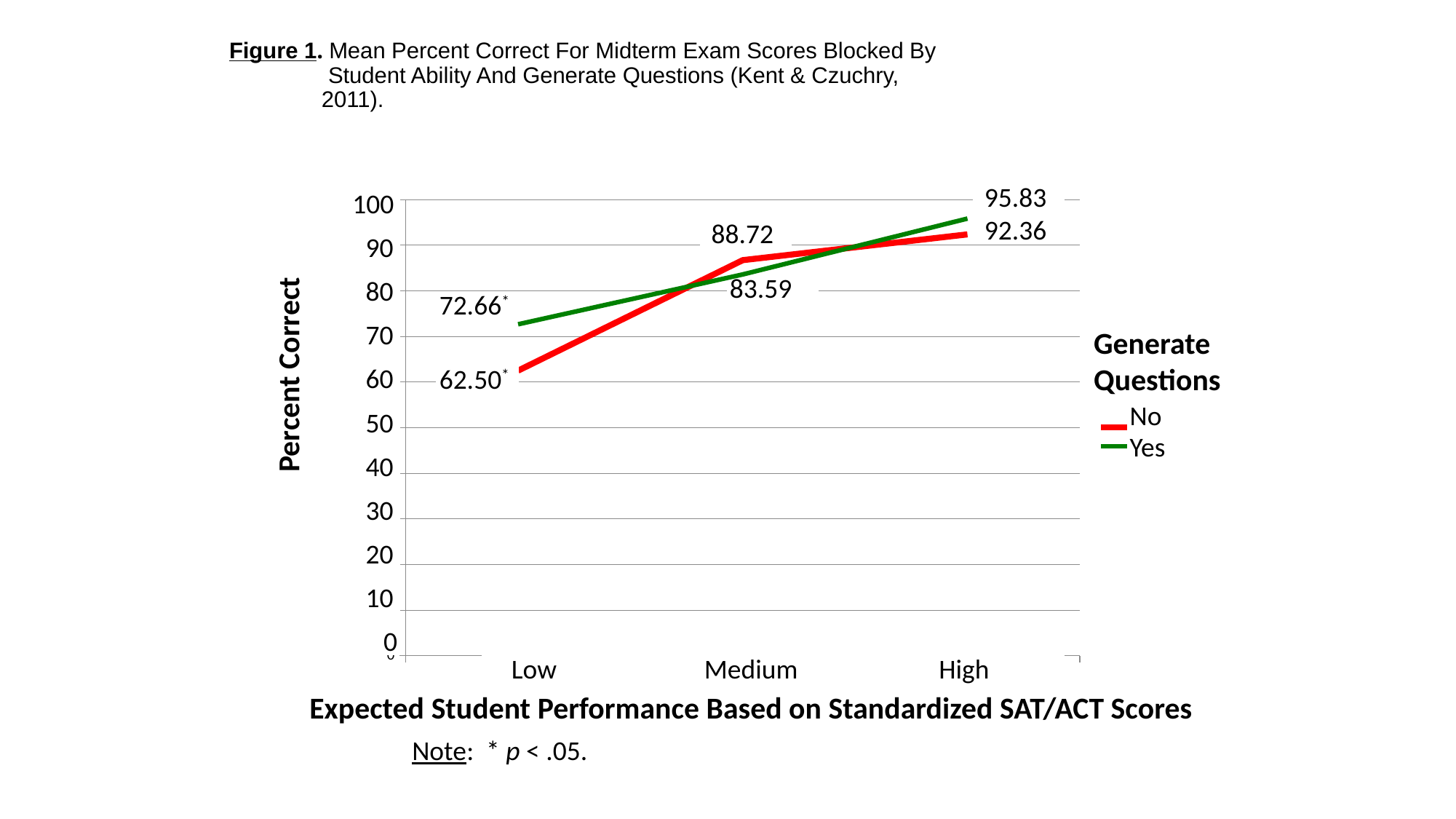
What kind of chart is shown on the slide? line chart Does the No series rise or fall from Low to High? rise At which level is the No series highest? High How many categories are shown on the x axis? 3 At which level is the Yes series lowest? Low At the Medium level, which series has the larger value, No or Yes? No What is the percent correct for the No series at the Medium level? 88.72 What is the percent correct for the Yes series at the High level? 95.83 What is the percent correct for the No series at the Low level? 62.50 What is the percent correct for the Yes series at the Low level? 72.66 How many series does the legend list? 2 What is the difference between the Yes and No values at the Low level? 10.16